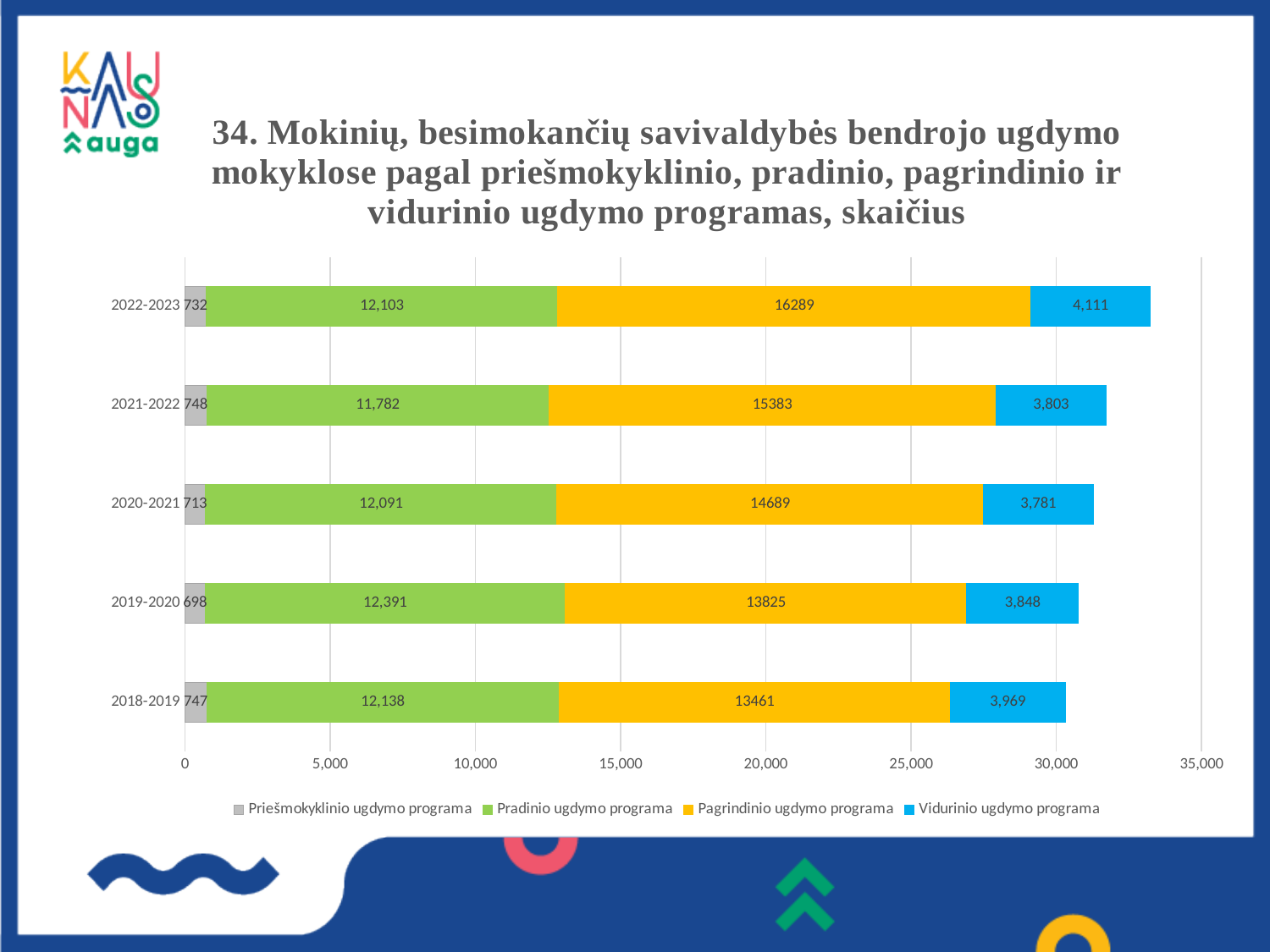
How many school years are shown on the chart? 5 Which is larger: the Vidurinio ugdymo programa value for 2022-2023 or for 2019-2020? 2022-2023 What is the difference between the Pagrindinio ugdymo programa values for 2022-2023 and 2021-2022? 906 What is the value for Priešmokyklinio ugdymo programa in 2020-2021? 713 What is the value for Pagrindinio ugdymo programa in 2022-2023? 16289 What is the value for Vidurinio ugdymo programa in 2018-2019? 3,969 What kind of chart is shown on the slide? Stacked bar chart How many series does the legend list? 4 Which school year has the lowest value for Pradinio ugdymo programa? 2021-2022 What is the total of the stacked bar for 2022-2023? 33,235 Does the value for Pagrindinio ugdymo programa rise or fall from 2018-2019 to 2022-2023? Rises Which school year has the highest value for Pagrindinio ugdymo programa? 2022-2023